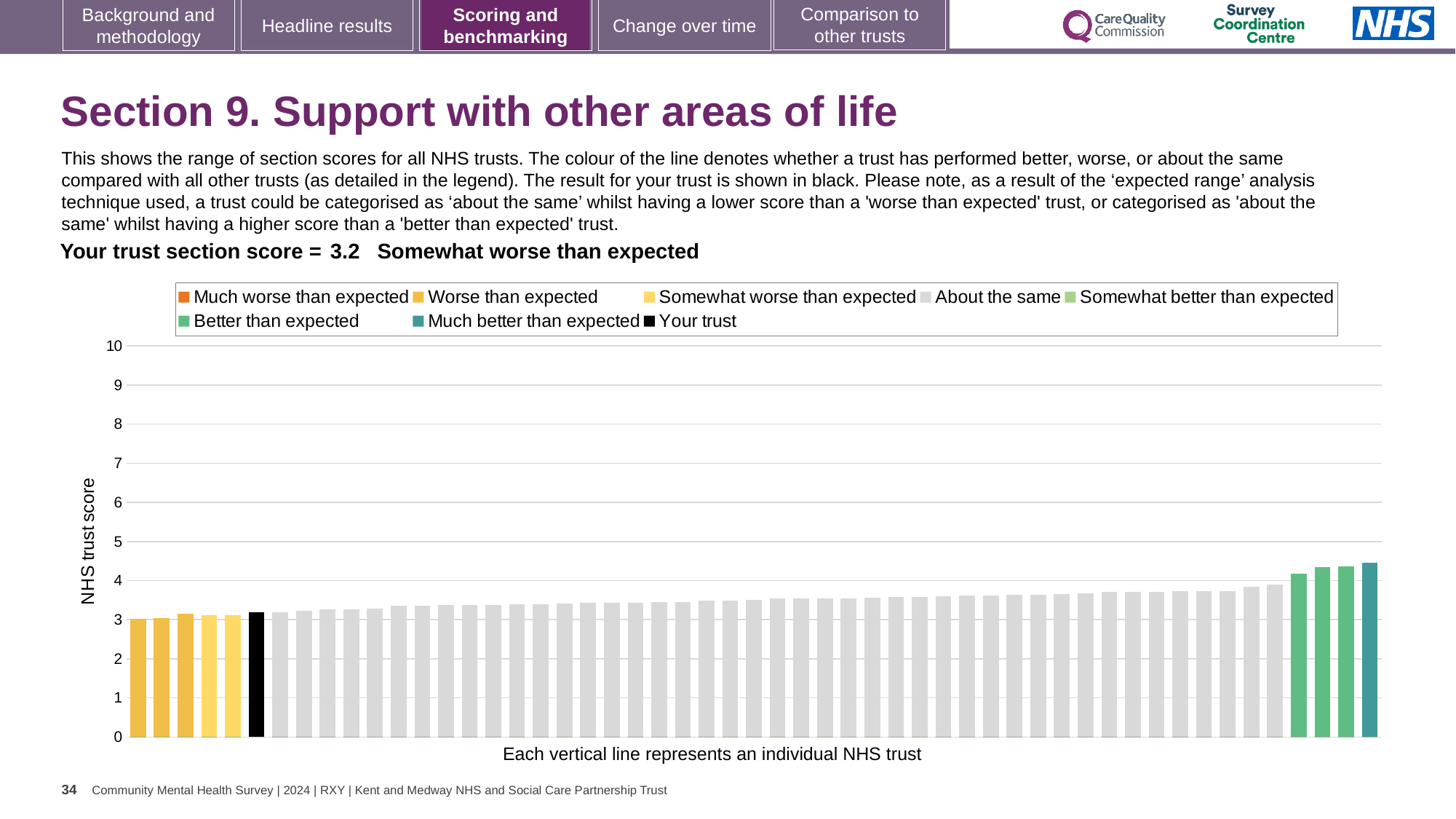
Which performance category is your trust placed in for this section? Somewhat worse than expected How many bars are coloured as 'Much worse than expected'? 0 How many bars are coloured as 'Better than expected'? 3 Which legend category does the tallest bar belong to? Much better than expected Do the bar values rise or fall moving from left to right along the x axis? Rise What kind of chart is shown on the slide? Bar chart Is the value of the tallest bar greater or less than 4? greater How many entries does the chart legend list? 8 Is the value of the shortest bar greater or less than 2? greater What is the label on the vertical axis of the chart? NHS trust score What is the section score for your trust? 3.2 Is the value of the tallest bar greater or less than 5? less